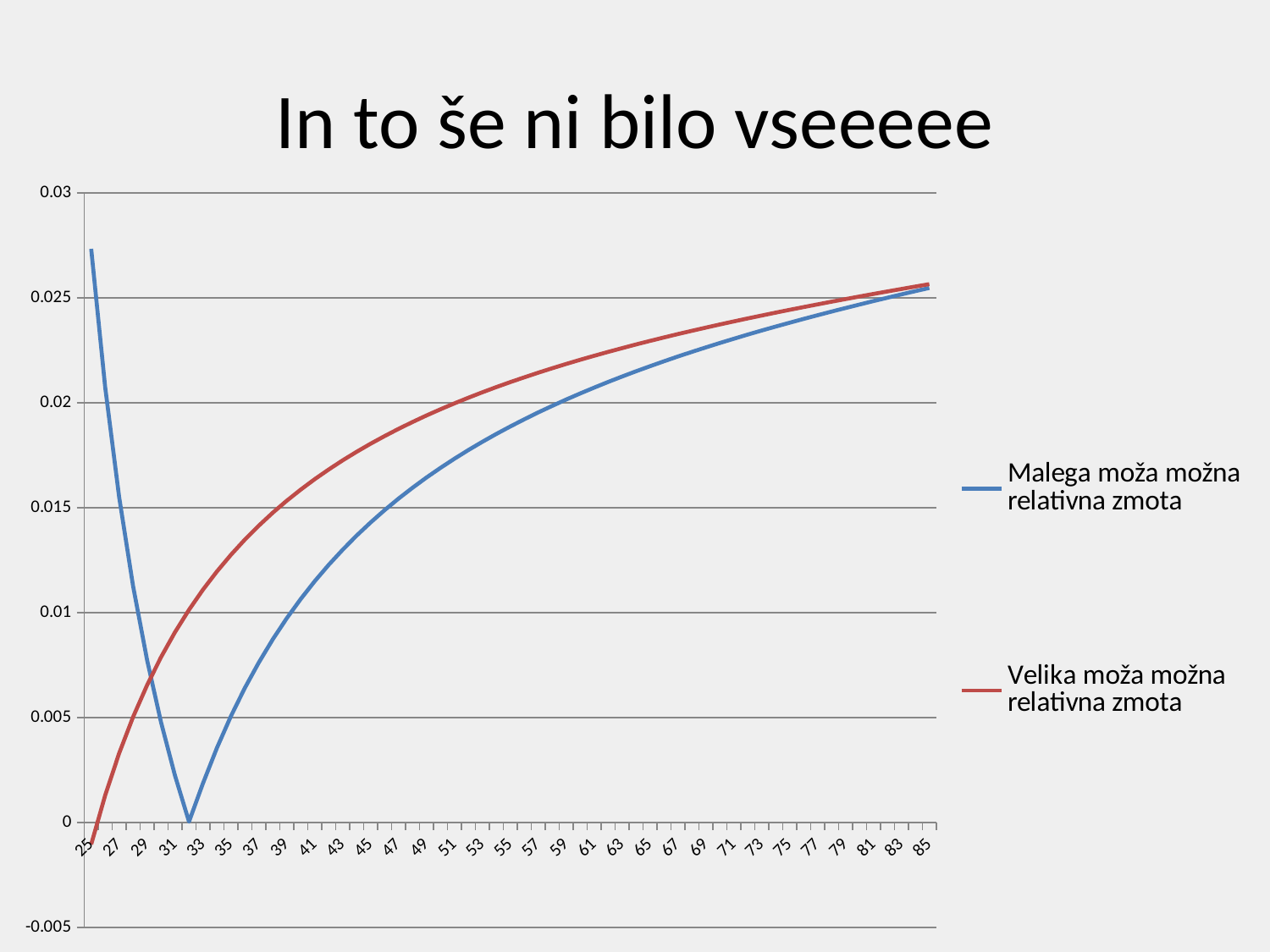
Is the value of 'Malega moža možna relativna zmota' at x = 55 greater or less than 0.02? less How many x-axis tick labels are shown (from 25 to 85)? 31 How many series does the legend list? 2 What kind of chart is shown on the slide? line chart At x = 45, which series has the higher value? Velika moža možna relativna zmota Which colour is the line for 'Velika moža možna relativna zmota'? red At x = 27, which series has the higher value? Malega moža možna relativna zmota Is the value of 'Malega moža možna relativna zmota' at x = 33 greater or less than 0.005? less What are the two series named in the legend? Malega moža možna relativna zmota; Velika moža možna relativna zmota Is the value of 'Malega moža možna relativna zmota' at x = 25 greater or less than 0.025? greater Does the 'Velika moža možna relativna zmota' line rise or fall as x increases from 25 to 85? rise